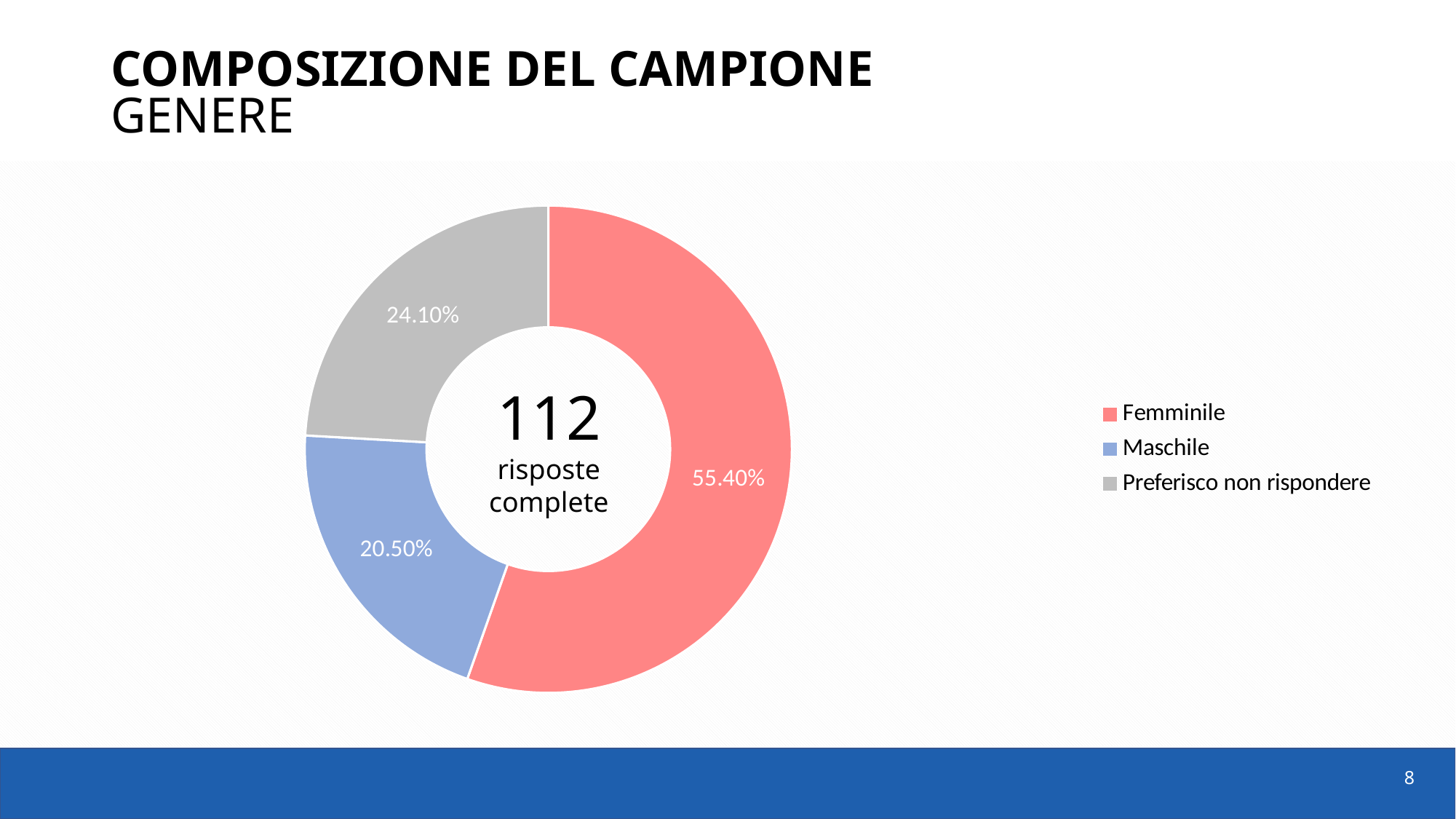
What share of the sample chose Preferisco non rispondere? 24.10% What kind of chart is shown on the slide? Doughnut (pie) chart How many categories does the chart show? 3 Which category has the largest share of the sample? Femminile Which category has the smallest share of the sample? Maschile What is the difference in percentage points between the Preferisco non rispondere and Maschile shares? 3.60% How many complete responses does the centre of the chart report? 112 Which colour represents Maschile in the legend? Blue What share of the sample is Femminile? 55.40% What share of the sample is Maschile? 20.50% What is the difference in percentage points between the Femminile and Maschile shares? 34.90% Which is larger, the share for Preferisco non rispondere or the share for Maschile? Preferisco non rispondere